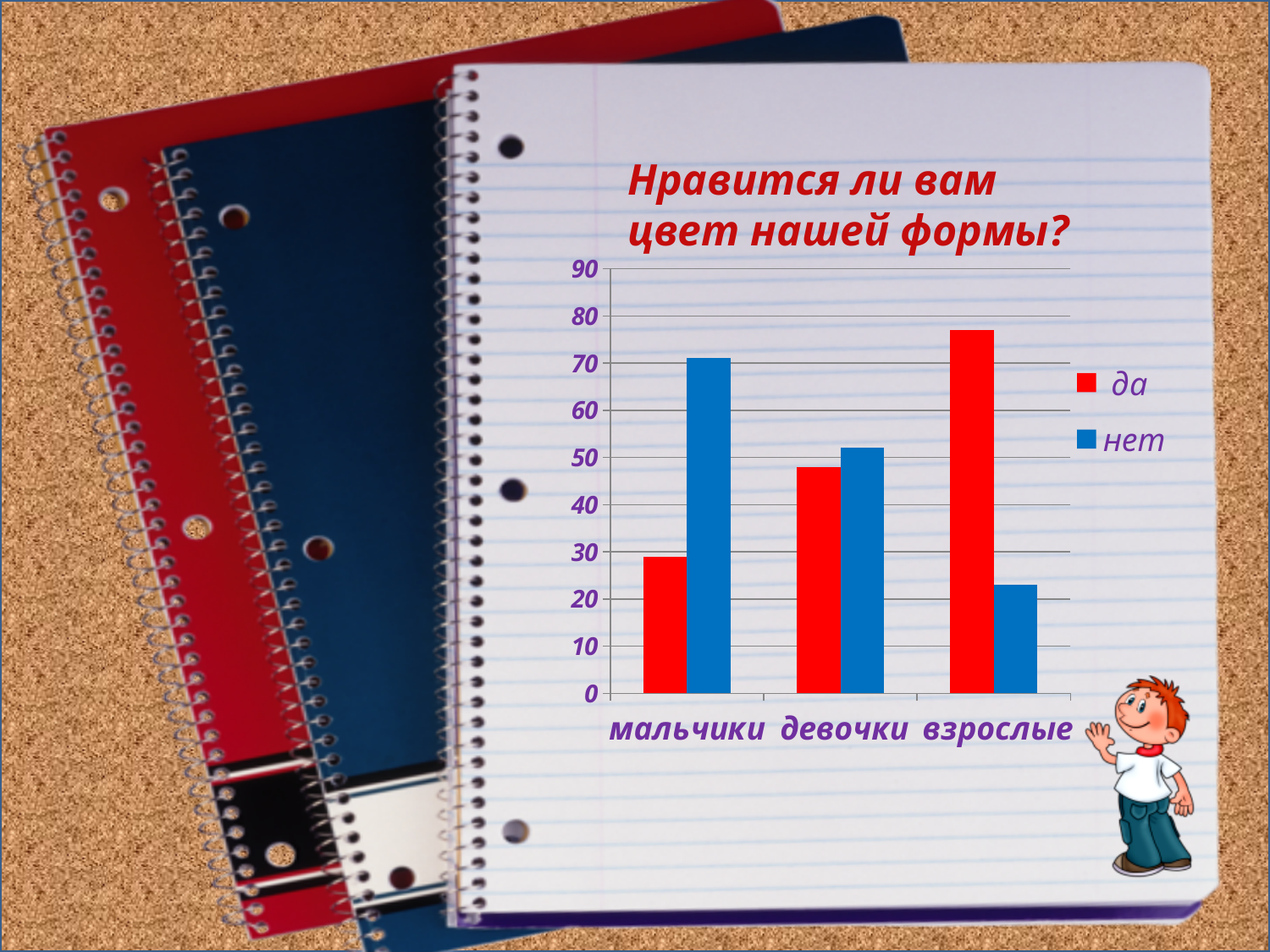
Which category has the highest value for the series "да"? взрослые Which category has the highest value for the series "нет"? мальчики For взрослые, which is larger: "да" or "нет"? да Which category has the lowest value for the series "да"? мальчики Which category has the lowest value for the series "нет"? взрослые What is the title of the chart? Нравится ли вам цвет нашей формы? How many categories are shown on the x axis? 3 Is the value of "нет" for взрослые greater or less than 30? less Is the value of "нет" for мальчики greater or less than 60? greater For мальчики, which is larger: "да" or "нет"? нет How many series does the legend list? 2 What kind of chart is shown on the slide? bar chart